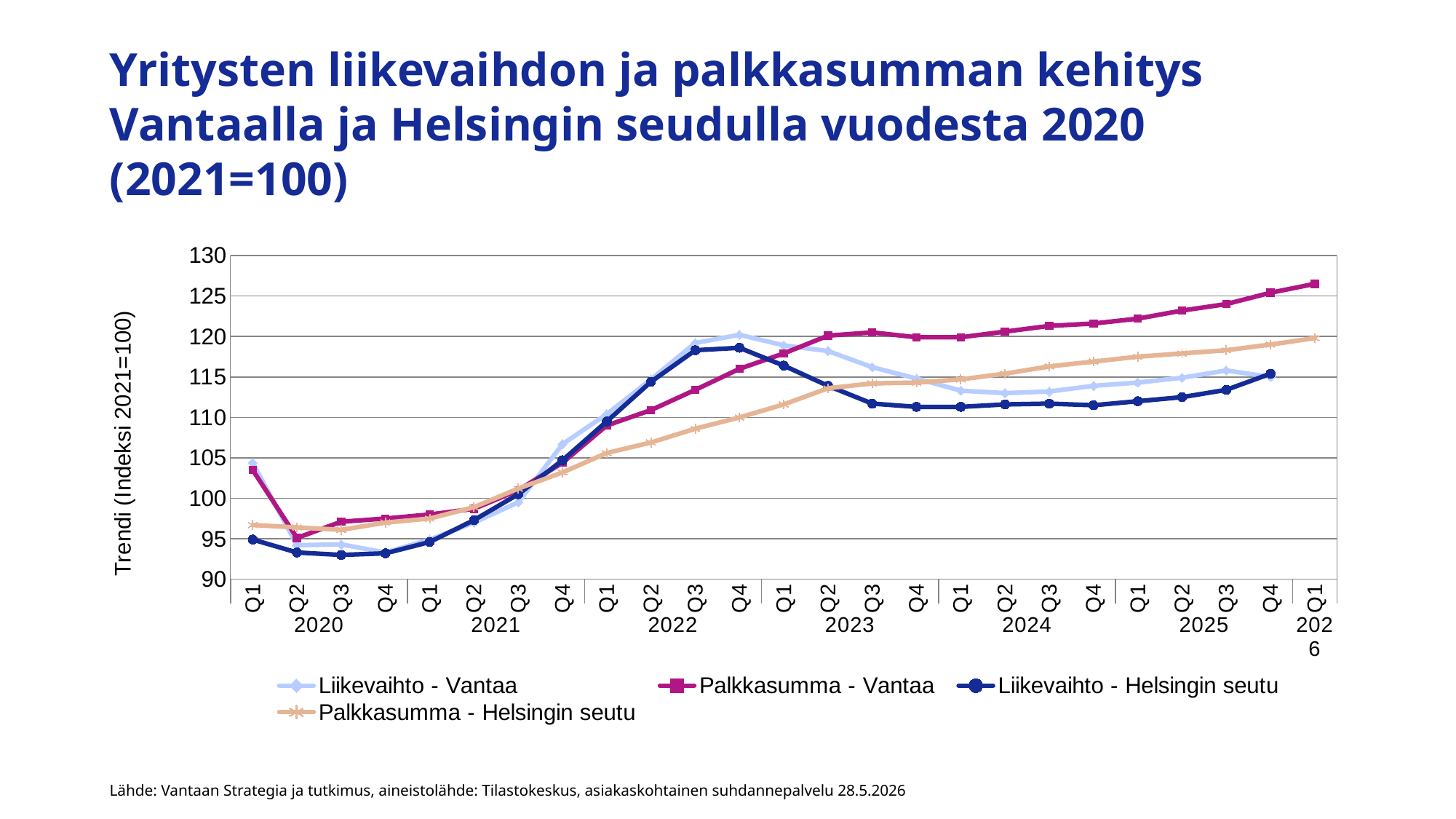
In Q4 2025, which is higher: Palkkasumma - Vantaa or Liikevaihto - Helsingin seutu? Palkkasumma - Vantaa Is the value for Palkkasumma - Helsingin seutu in Q4 2024 greater or less than 115? greater In Q4 2022, which is higher: Liikevaihto - Vantaa or Palkkasumma - Helsingin seutu? Liikevaihto - Vantaa Which series has the highest value at the right end of the chart (Q1 2026)? Palkkasumma - Vantaa How many quarterly points are shown along the x axis? 25 Is the value for Palkkasumma - Vantaa in Q1 2026 greater or less than 125? greater What kind of chart is shown on the slide? line chart How many series does the legend list? 4 Is the value for Palkkasumma - Vantaa in Q1 2020 greater or less than 100? greater Does Liikevaihto - Helsingin seutu rise or fall from Q4 2022 to Q4 2023? fall